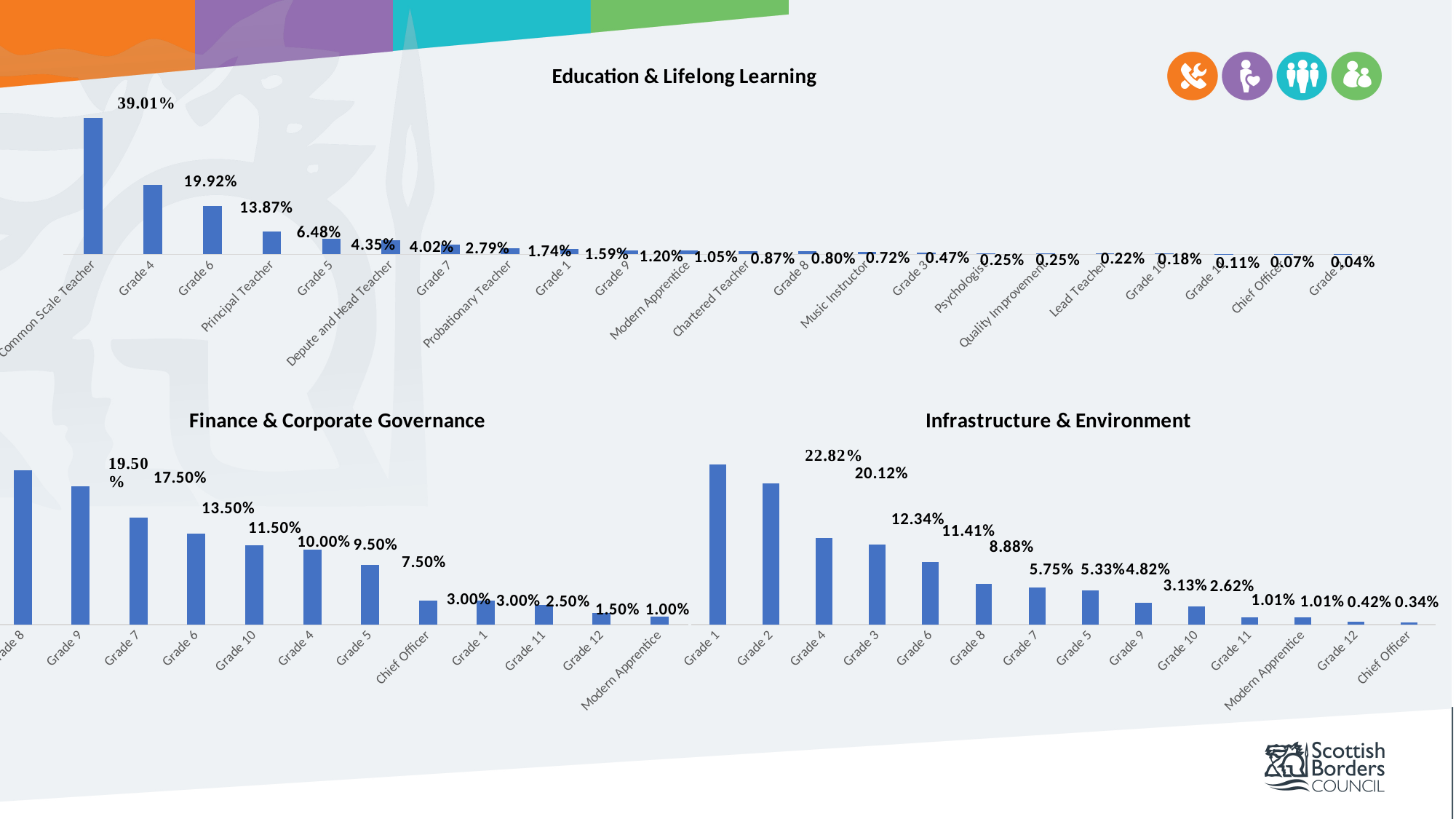
In the Infrastructure & Environment chart, which category has the highest value? Grade 1 In the Education & Lifelong Learning chart, what is the value for Grade 4? 19.92% In the Education & Lifelong Learning chart, which category has the highest value? Common Scale Teacher In the Finance & Corporate Governance chart, which category has the lowest value? Modern Apprentice In the Education & Lifelong Learning chart, do the values rise or fall from left to right along the x axis? Fall How many categories are shown in the Education & Lifelong Learning chart? 22 What kind of chart is the Education & Lifelong Learning chart? Bar chart In the Education & Lifelong Learning chart, what is the value for Common Scale Teacher? 39.01% How many categories are shown in the Finance & Corporate Governance chart? 12 In the Finance & Corporate Governance chart, which is larger, the value for Grade 7 or the value for Grade 6? Grade 7 How many categories are shown in the Infrastructure & Environment chart? 14 In the Education & Lifelong Learning chart, what is the difference between the values for Common Scale Teacher and Grade 4? 19.09%